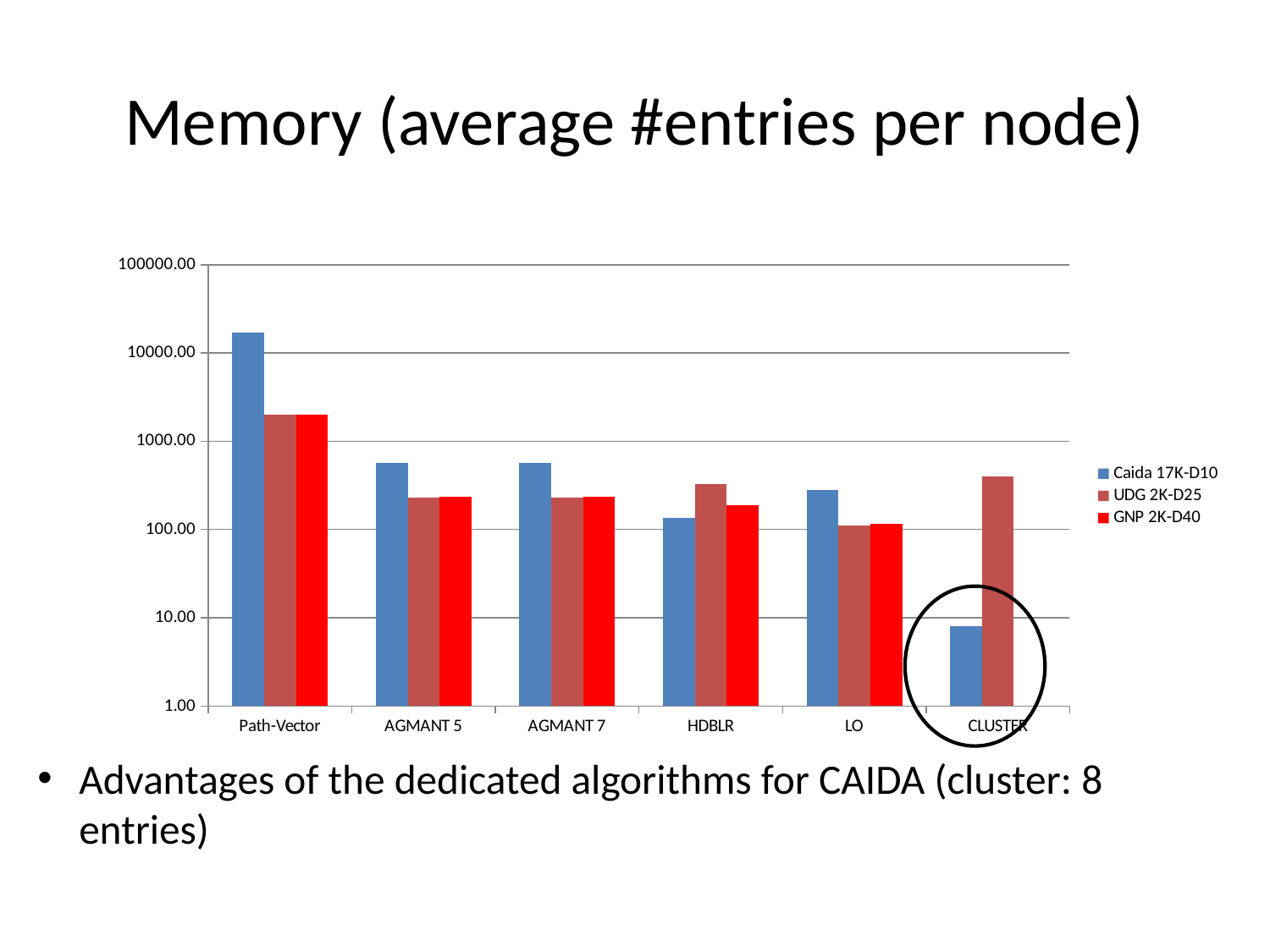
What is the title of the chart on the slide? Memory (average #entries per node) How many categories are shown on the x axis of the chart? 6 For Path-Vector, which series has the larger value: Caida 17K-D10 or GNP 2K-D40? Caida 17K-D10 What kind of chart is shown on the slide? bar chart Is the Caida 17K-D10 value for CLUSTER greater or less than 10.00? less Which category has the lowest value for the Caida 17K-D10 series? CLUSTER Is the Caida 17K-D10 value for Path-Vector greater or less than 10000.00? greater How many series does the chart's legend list? 3 Which category has the highest value for the Caida 17K-D10 series? Path-Vector Which series is drawn in blue in the chart? Caida 17K-D10 Is the UDG 2K-D25 value for Path-Vector greater or less than 1000.00? greater For HDBLR, which series has the larger value: Caida 17K-D10 or UDG 2K-D25? UDG 2K-D25